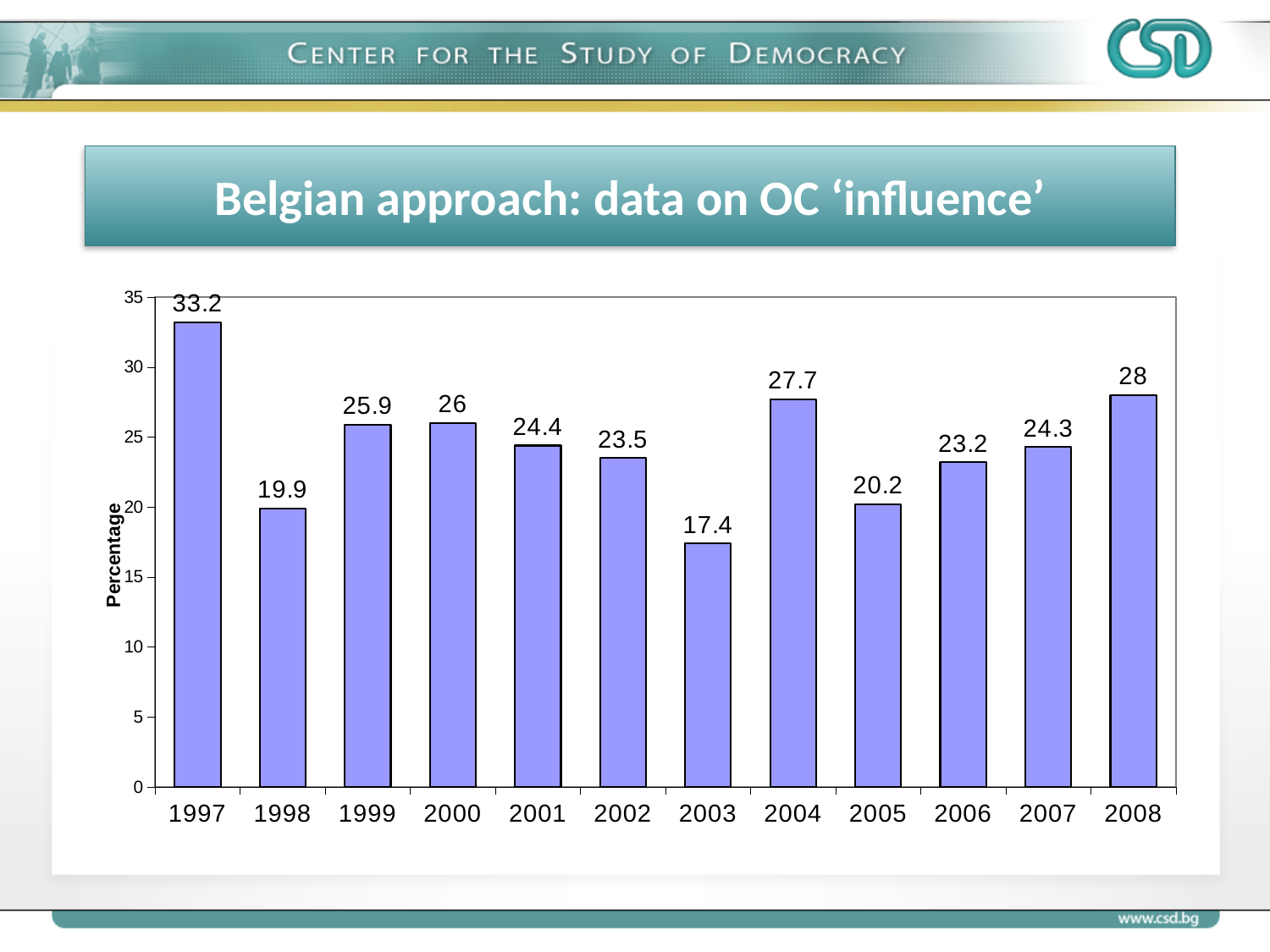
How many years are shown on the x axis? 12 Is the value for 2002 greater or less than 25? less Which year has a larger value, 2000 or 2006? 2000 What is the percentage value for 2008? 28 What is the percentage value for 1997? 33.2 Which year has the highest percentage? 1997 What is the label of the y axis? Percentage What is the percentage value for 2003? 17.4 What kind of chart is shown on the slide? bar chart Which year has the lowest percentage? 2003 What is the difference between the values for 2004 and 2005? 7.5 What is the difference between the values for 1997 and 1998? 13.3